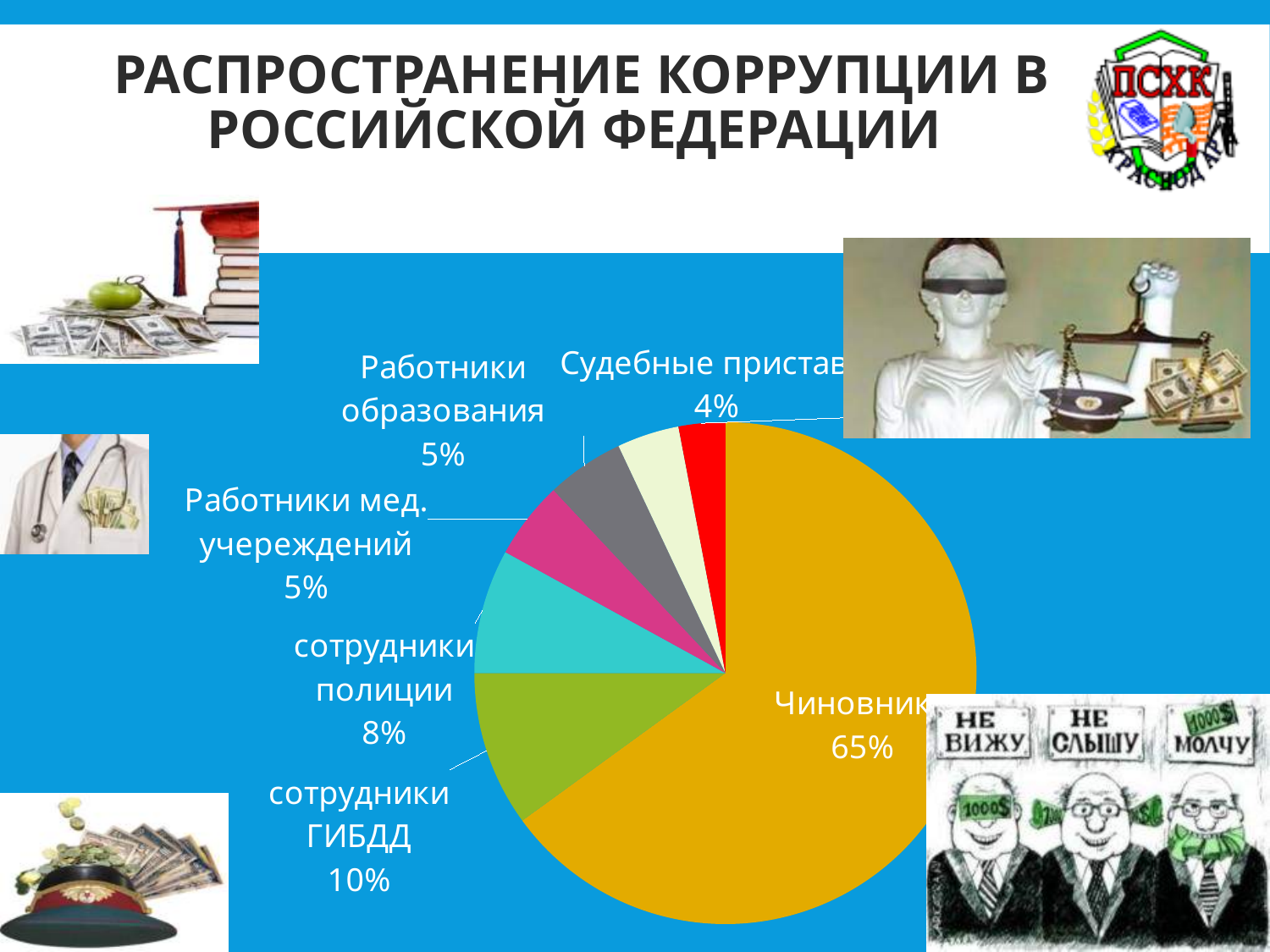
What percentage is shown for сотрудники ГИБДД? 10% Which is larger, the share for сотрудники ГИБДД or for сотрудники полиции? сотрудники ГИБДД What share of the pie is labelled for Чиновники? 65% What is the difference between the shares for сотрудники полиции and Судебные приставы? 4% What percentage is shown for сотрудники полиции? 8% What percentage is shown for Судебные приставы? 4% What percentage is shown for Работники мед. учереждений? 5% What is the title of the slide containing the chart? РАСПРОСТРАНЕНИЕ КОРРУПЦИИ В РОССИЙСКОЙ ФЕДЕРАЦИИ Which category has the largest slice of the pie? Чиновники What is the difference between the shares for Чиновники and сотрудники ГИБДД? 55% What kind of chart is shown on the slide? pie chart What percentage is shown for Работники образования? 5%